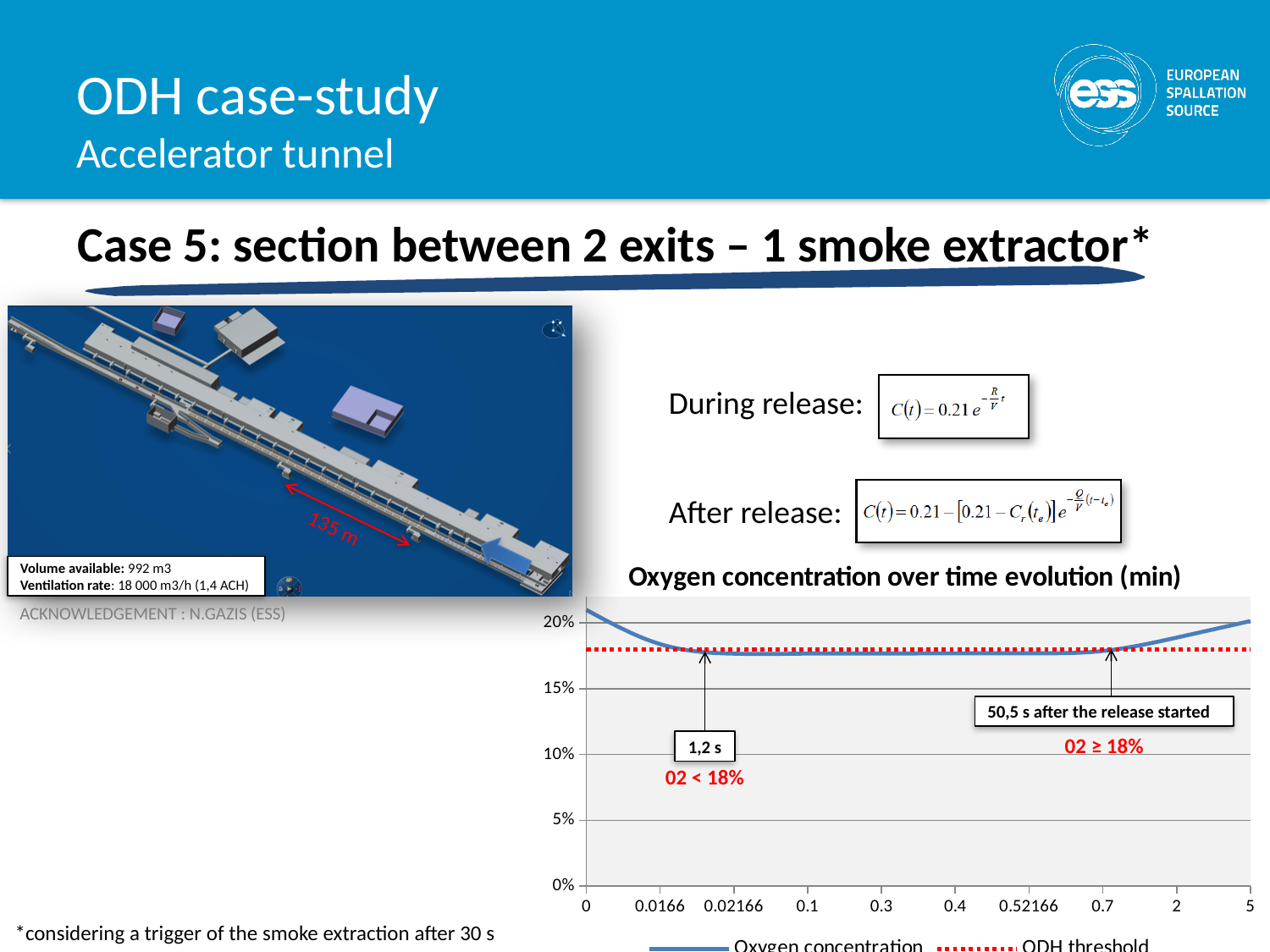
Is the oxygen concentration at x = 0.1 greater or less than 15%? greater Is the ODH threshold line on the chart greater or less than 15%? greater Which two series are listed in the chart legend? Oxygen concentration and ODH threshold Is the ODH threshold line on the chart greater or less than 20%? less According to the chart annotation, how long after the release started does the oxygen concentration return to 18% or above? 50,5 s after the release started Between x = 0.7 and x = 5, does the oxygen concentration rise or fall? rise According to the chart annotation, after how long does the oxygen concentration drop below 18%? 1,2 s What is the title of the chart on the slide? Oxygen concentration over time evolution (min) How many series does the chart legend list? 2 How many tick labels are shown on the x axis of the chart? 10 What kind of chart is shown on the slide? line chart Between x = 0 and x = 0.1, does the oxygen concentration rise or fall? fall